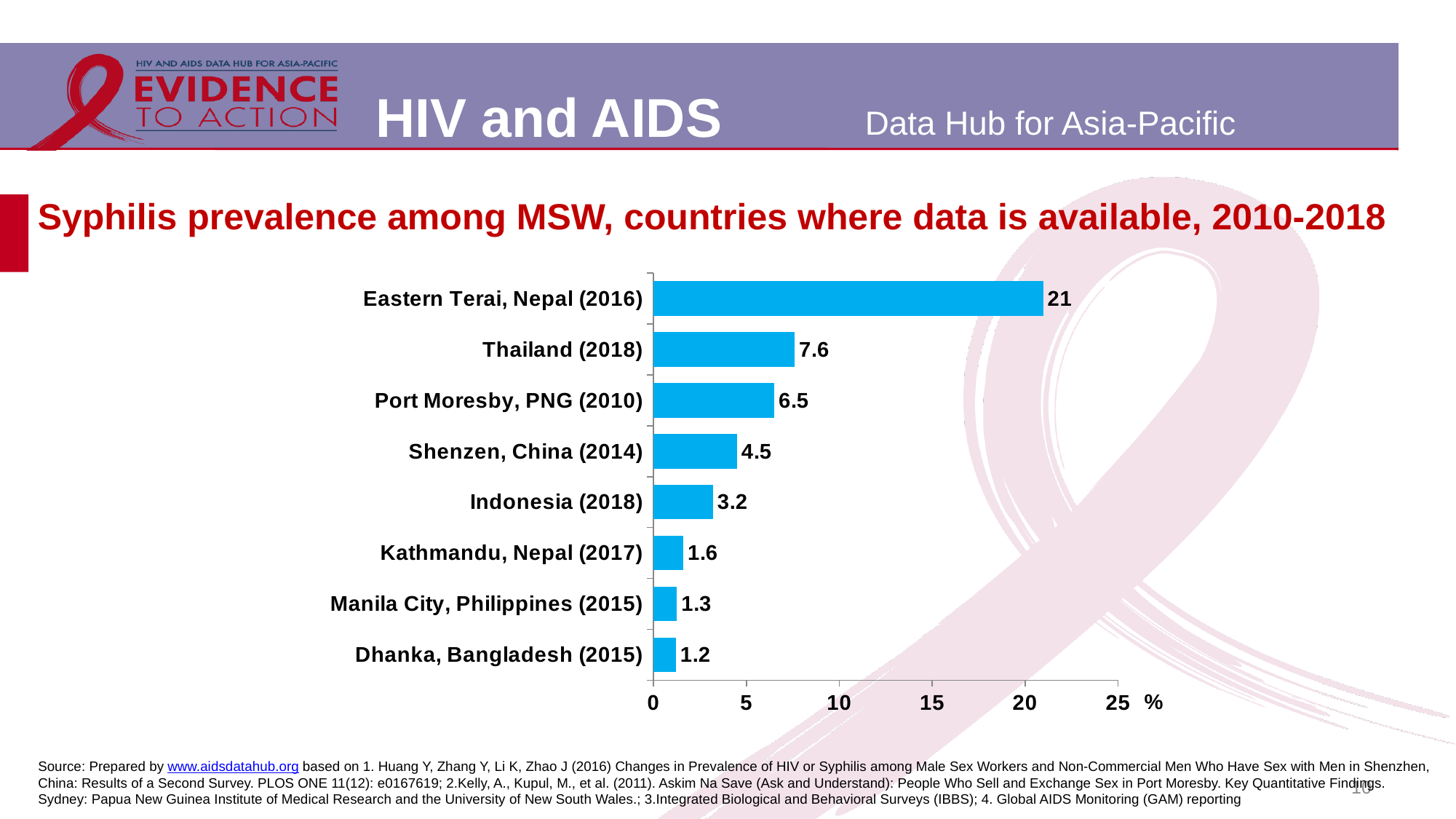
How many locations are shown on the chart? 8 What is the difference between the values for Eastern Terai, Nepal (2016) and Kathmandu, Nepal (2017)? 19.4 What is the difference between the values for Thailand (2018) and Port Moresby, PNG (2010)? 1.1 What value is shown for Indonesia (2018)? 3.2 What type of chart is shown on the slide? Bar chart What is the syphilis prevalence among MSW in Thailand (2018)? 7.6 Which location has the lowest syphilis prevalence among MSW on the chart? Dhanka, Bangladesh (2015) Which location has the highest syphilis prevalence among MSW on the chart? Eastern Terai, Nepal (2016) What unit is shown at the end of the horizontal axis? % Which has a higher value: Indonesia (2018) or Manila City, Philippines (2015)? Indonesia (2018) What is the syphilis prevalence among MSW in Eastern Terai, Nepal (2016)? 21 What value is shown for Shenzen, China (2014)? 4.5